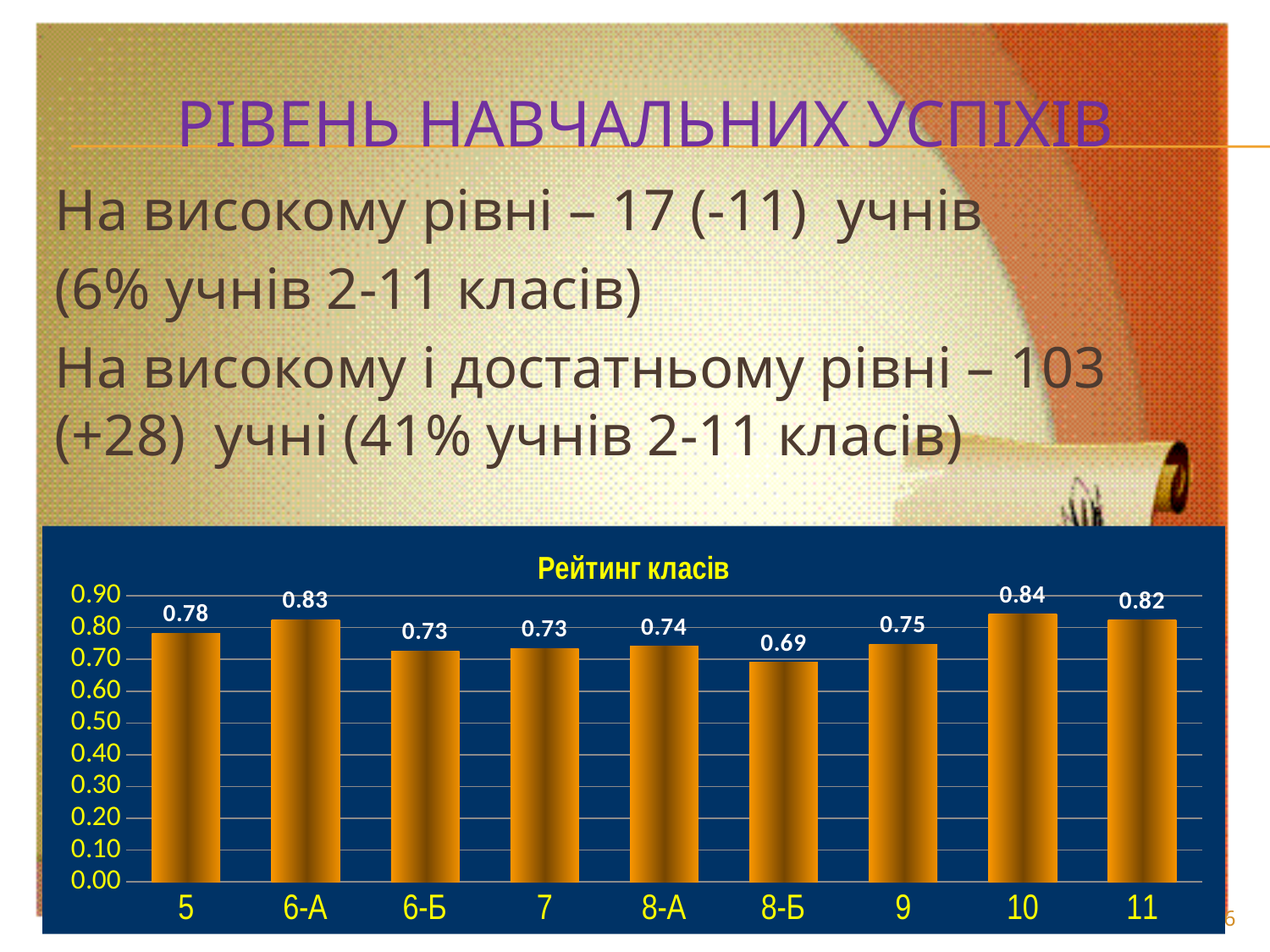
Which class has the highest value in the 'Рейтинг класів' chart? 10 What is the difference between the values for class 10 and class 8-Б in the 'Рейтинг класів' chart? 0.15 Which class has the lowest value in the 'Рейтинг класів' chart? 8-Б What is the value for class 10 in the 'Рейтинг класів' chart? 0.84 What is the value for class 8-Б in the 'Рейтинг класів' chart? 0.69 What is the title of the chart on the slide? Рейтинг класів What is the value for class 5 in the 'Рейтинг класів' chart? 0.78 How many classes are shown on the x axis of the 'Рейтинг класів' chart? 9 Is the value for class 6-А in the 'Рейтинг класів' chart greater or less than 0.80? greater What kind of chart is 'Рейтинг класів'? bar chart Which has a larger value in the 'Рейтинг класів' chart, class 9 or class 11? 11 What is the difference between the values for class 6-А and class 6-Б in the 'Рейтинг класів' chart? 0.10